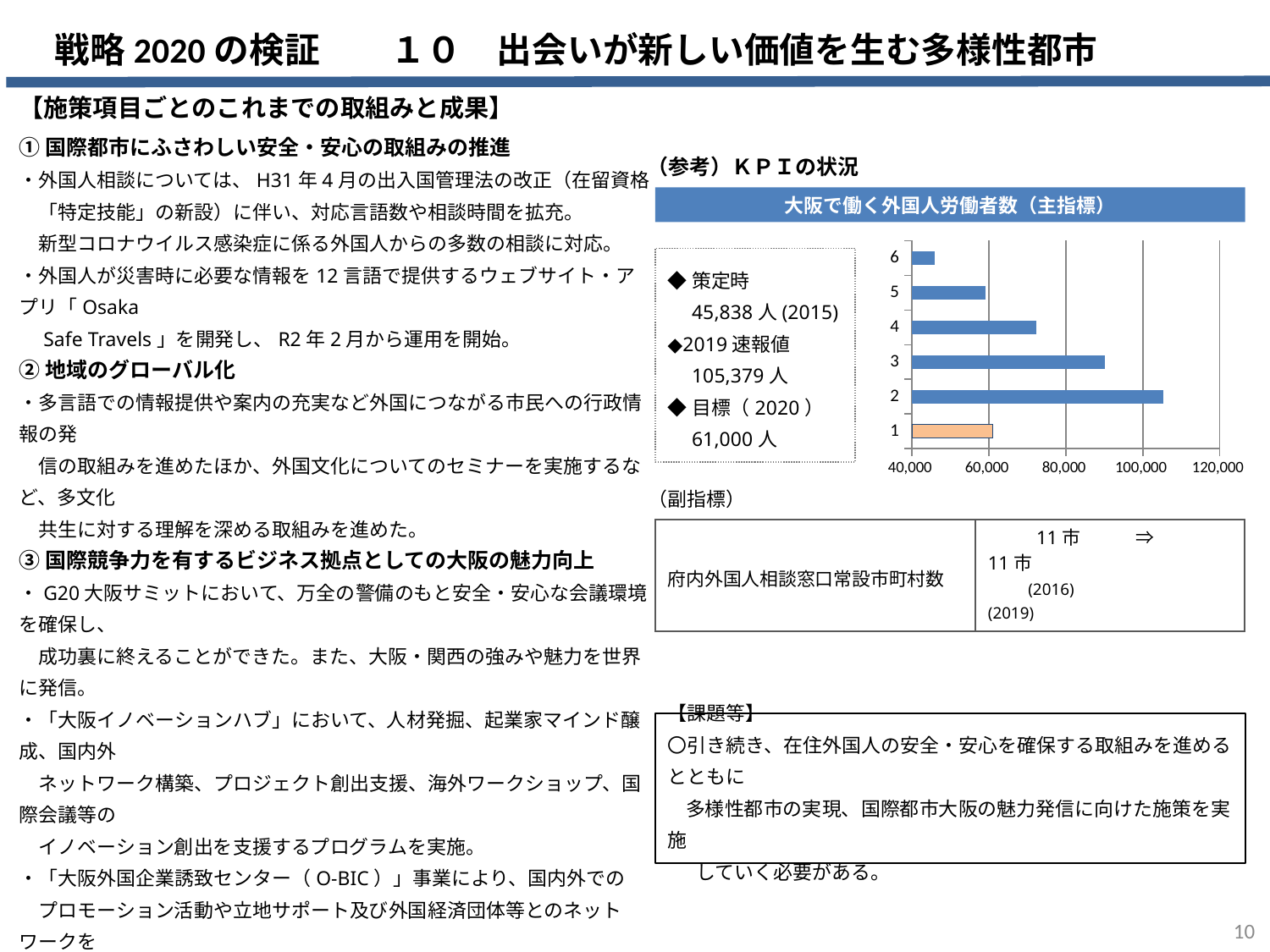
In the 大阪で働く外国人労働者数 chart, which is larger, the value for category 3 or the value for category 4? category 3 In the 大阪で働く外国人労働者数 chart, which category's bar is coloured orange instead of blue? 1 In the 大阪で働く外国人労働者数 chart, is the value for category 3 greater or less than 80,000? greater In the 大阪で働く外国人労働者数 chart, do the bar values increase or decrease going from category 2 to category 6? decrease In the 大阪で働く外国人労働者数 chart, which category has the longest bar? 2 In the 大阪で働く外国人労働者数 chart, is the value for category 4 greater or less than 80,000? less In the 大阪で働く外国人労働者数 chart, is the value for category 2 greater or less than 100,000? greater What kind of chart is shown under the heading 大阪で働く外国人労働者数（主指標）? bar chart In the 大阪で働く外国人労働者数 chart, which is larger, the value for category 2 or the value for category 6? category 2 In the 大阪で働く外国人労働者数 chart, which category has the shortest bar? 6 How many categories are plotted on the y axis of the 大阪で働く外国人労働者数 chart? 6